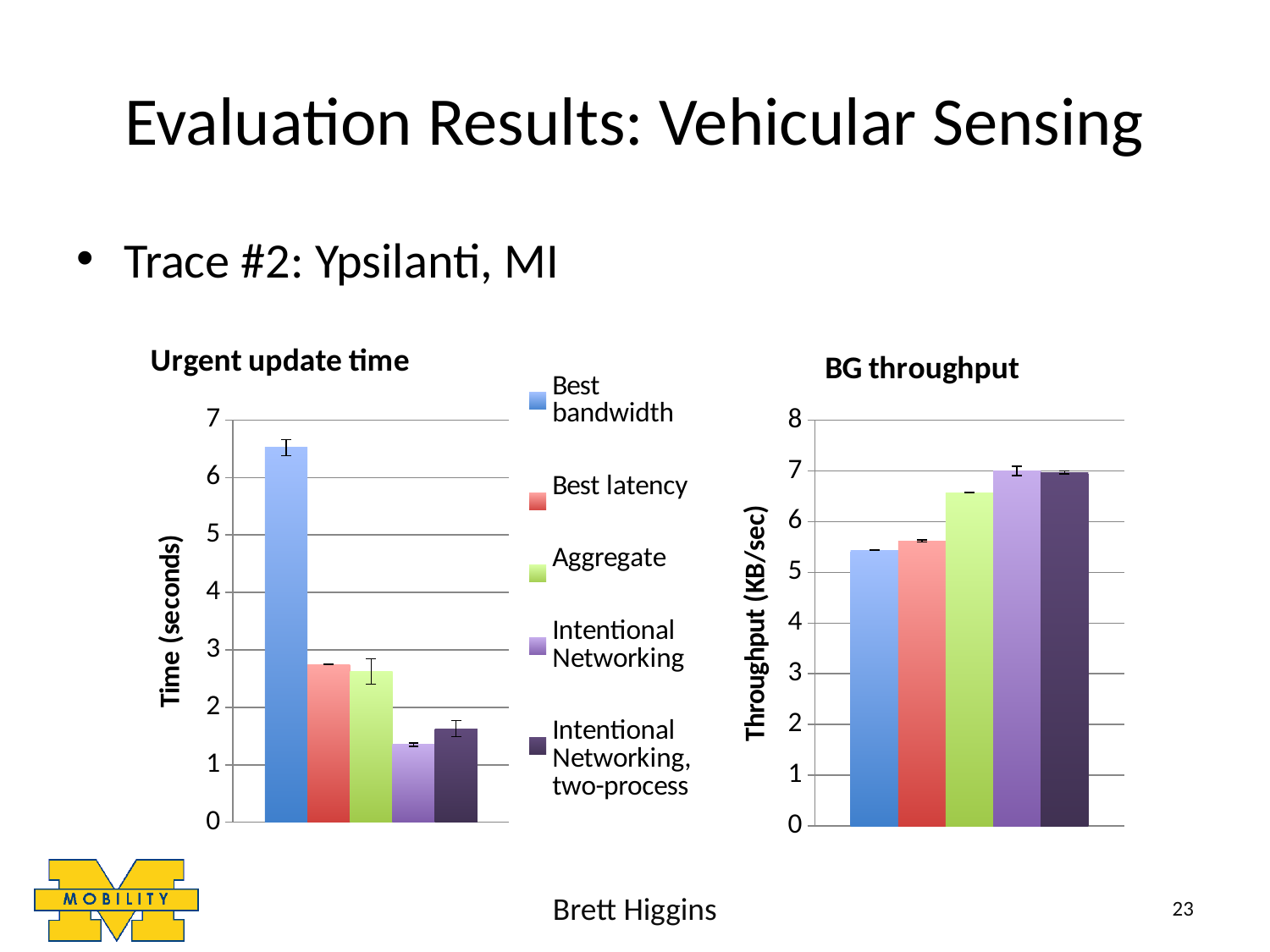
What kind of chart is the "Urgent update time" chart? bar chart In the "BG throughput" chart, is the value for Best bandwidth greater or less than 5? greater How many series does the legend list for the charts? 5 In the "Urgent update time" chart, which series has the lowest value? Intentional Networking In the "Urgent update time" chart, is the value for Best latency greater or less than 3? less In the "Urgent update time" chart, which series has the highest value? Best bandwidth In the "Urgent update time" chart, which is larger: Best latency or Intentional Networking? Best latency In the "Urgent update time" chart, is the value for Best bandwidth greater or less than 6? greater What is the y-axis label of the "BG throughput" chart? Throughput (KB/sec) In the "BG throughput" chart, which is larger: Aggregate or Best bandwidth? Aggregate